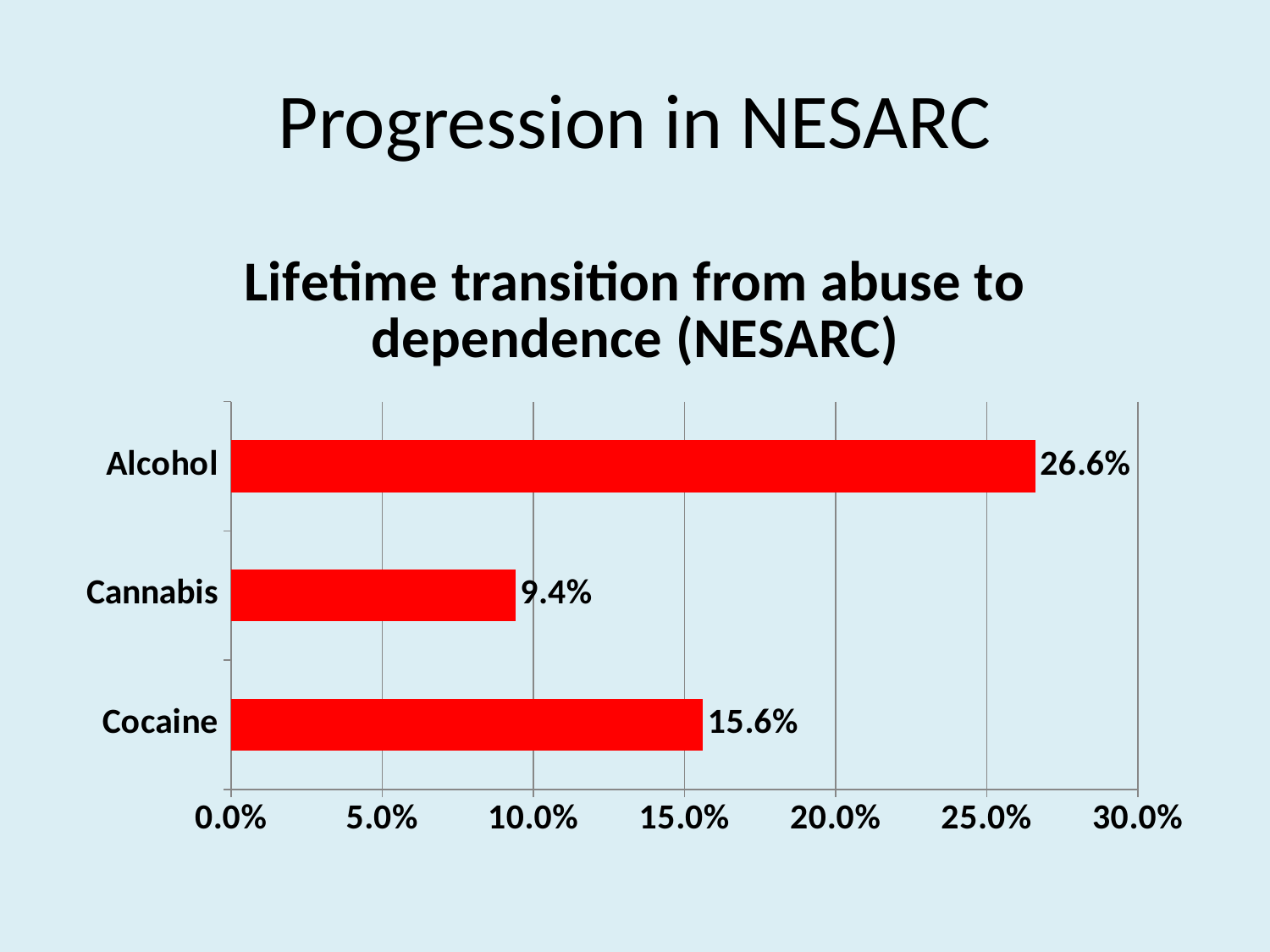
Which category has the highest value? Alcohol What is the value for Cannabis? 9.4% What is the value for Alcohol? 26.6% How many categories are shown in the chart? 3 What is the title of the chart? Lifetime transition from abuse to dependence (NESARC) What is the difference between the values for Cocaine and Cannabis? 6.2% What is the value for Cocaine? 15.6% Which is larger, the value for Cannabis or the value for Cocaine? Cocaine What is the difference between the values for Alcohol and Cocaine? 11.0% Which category has the lowest value? Cannabis What kind of chart is shown on the slide? Bar chart Is the value for Alcohol greater or less than 25.0%? greater